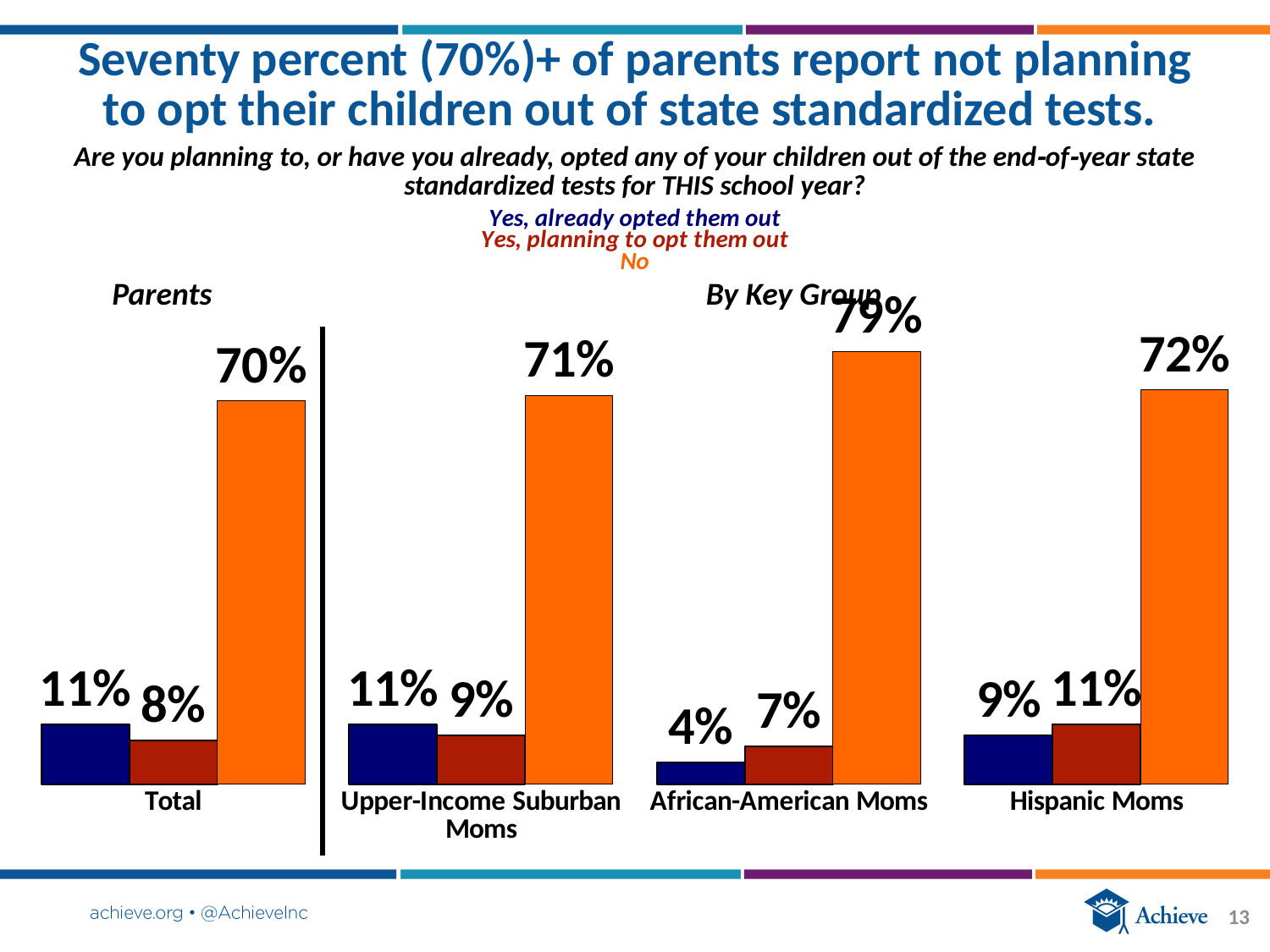
What percentage of Total parents answered "No"? 70% Which colour represents the "No" response in the chart? Orange What is the difference between the "No" percentage for African-American Moms and for Total? 9% Which is larger: the "Yes, planning to opt them out" value for Hispanic Moms or for African-American Moms? Hispanic Moms What kind of chart is shown on the slide? Bar chart What percentage of Hispanic Moms said "Yes, planning to opt them out"? 11% What percentage of African-American Moms said "Yes, already opted them out"? 4% How many groups (categories) are shown on the x axis? 4 Which group has the lowest percentage saying "Yes, already opted them out"? African-American Moms How many response series does the legend list? 3 Which group has the highest percentage answering "No"? African-American Moms What percentage of Upper-Income Suburban Moms answered "No"? 71%